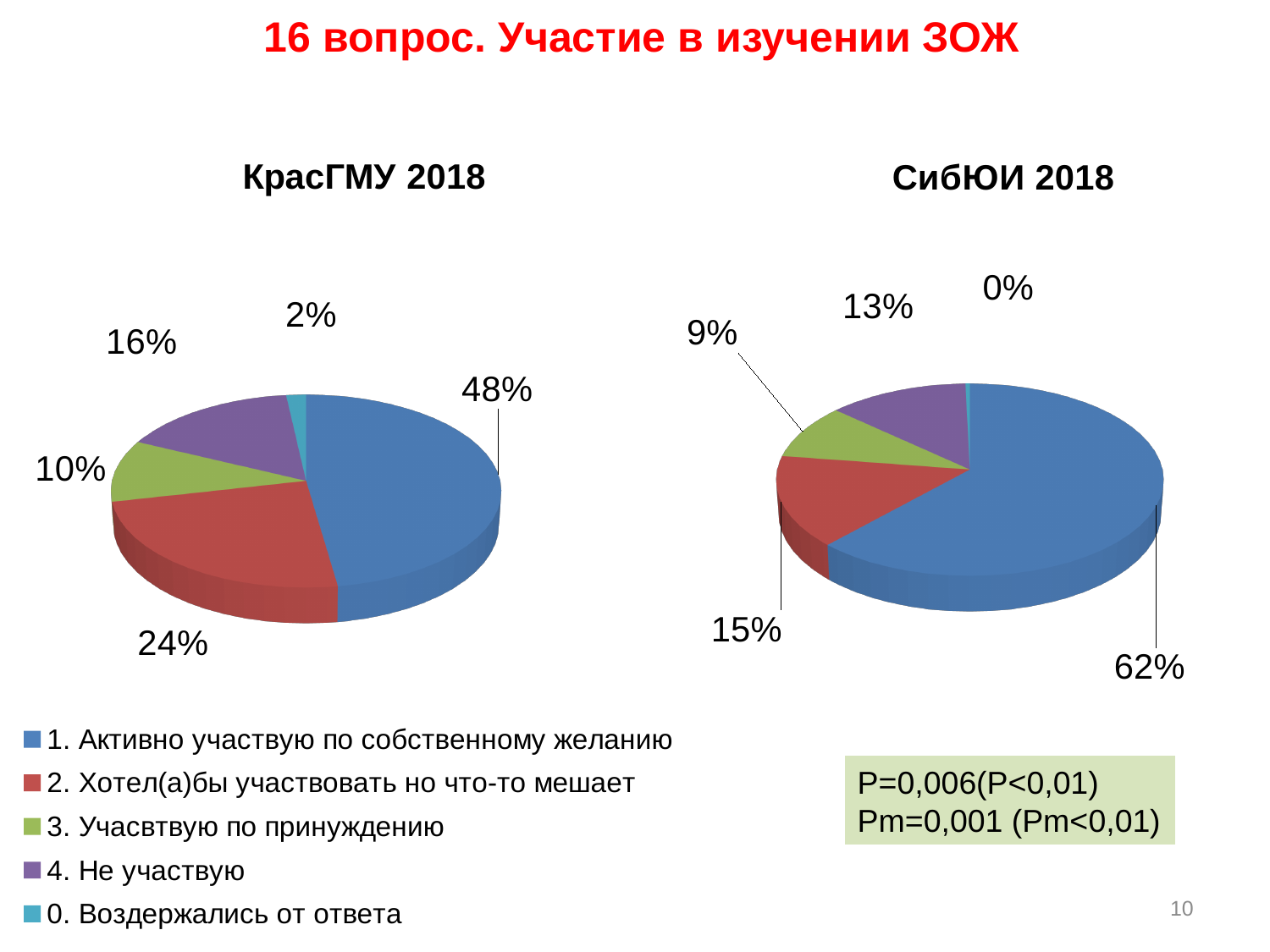
In the КрасГМУ 2018 chart, what share is shown for "1. Активно участвую по собственному желанию"? 48% Which chart shows a larger share for "4. Не участвую", КрасГМУ 2018 or СибЮИ 2018? КрасГМУ 2018 What is the difference between the share for "1. Активно участвую по собственному желанию" in the СибЮИ 2018 chart and in the КрасГМУ 2018 chart? 14% What colour represents "3. Учасвтвую по принуждению" in the charts? Green In the СибЮИ 2018 chart, what share is shown for "2. Хотел(а)бы участвовать но что-то мешает"? 15% In the СибЮИ 2018 chart, which category has the smallest slice? 0. Воздержались от ответа In the КрасГМУ 2018 chart, what is the difference between the shares for "2. Хотел(а)бы участвовать но что-то мешает" and "3. Учасвтвую по принуждению"? 14% What type of chart is the СибЮИ 2018 chart? Pie chart In the КрасГМУ 2018 chart, what share is shown for "4. Не участвую"? 16% In the СибЮИ 2018 chart, what share is shown for "0. Воздержались от ответа"? 0% In the КрасГМУ 2018 chart, which category has the largest slice? 1. Активно участвую по собственному желанию How many categories does the legend list? 5